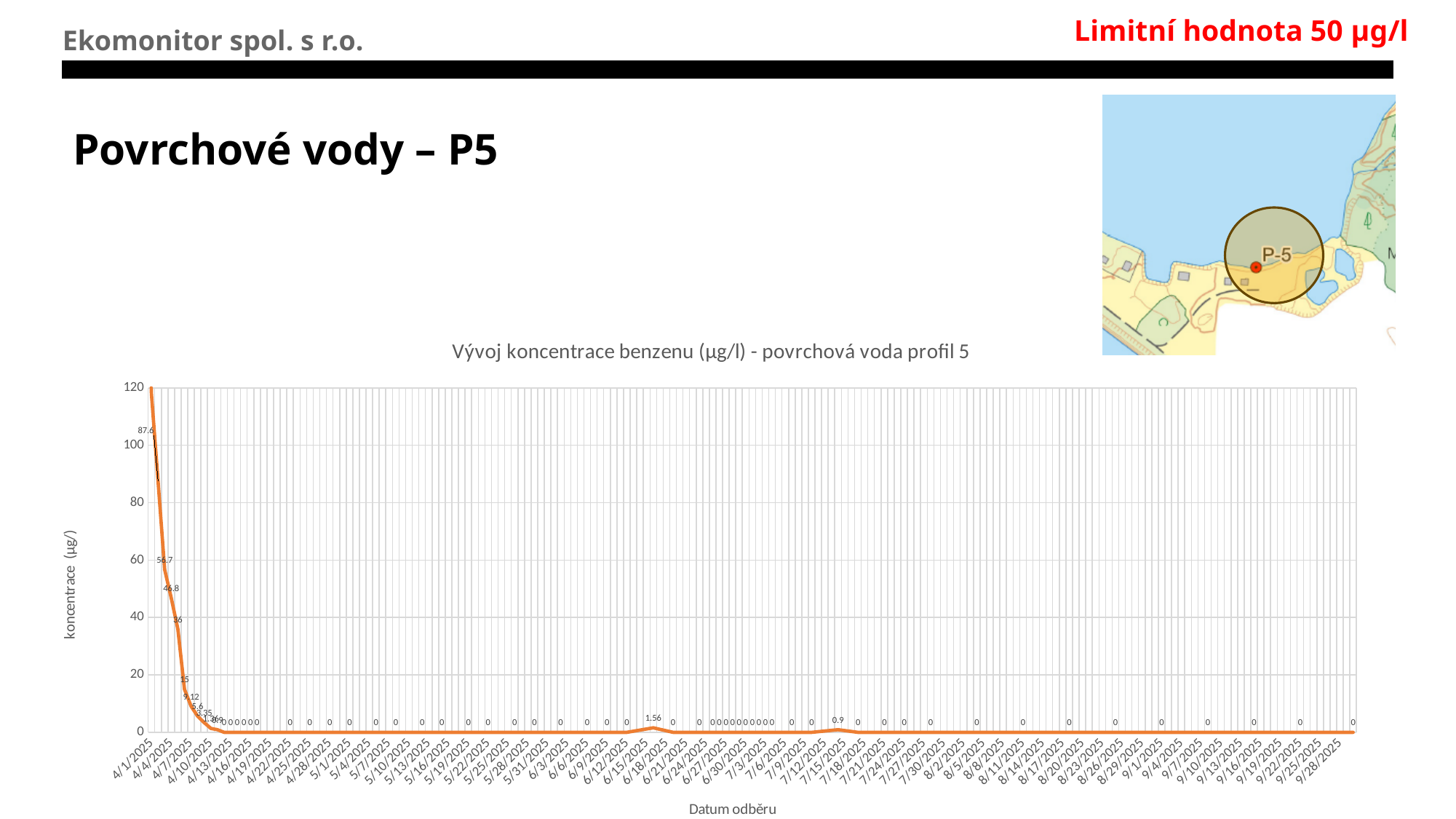
On which date is the benzene concentration highest? 4/1/2025 What is the title of the x axis of the chart? Datum odběru What kind of chart is shown on the slide? line chart Is the value for 4/7/2025 greater or less than 40? less Which is larger, the value for 4/1/2025 or the value for 5/1/2025? 4/1/2025 What is the title of the chart? Vývoj koncentrace benzenu (µg/l) - povrchová voda profil 5 Is the value for 9/28/2025 greater or less than 20? less Is the value for 4/1/2025 greater or less than 100? greater Do the benzene concentration values generally rise or fall along the x axis from 4/1/2025 to 9/28/2025? fall